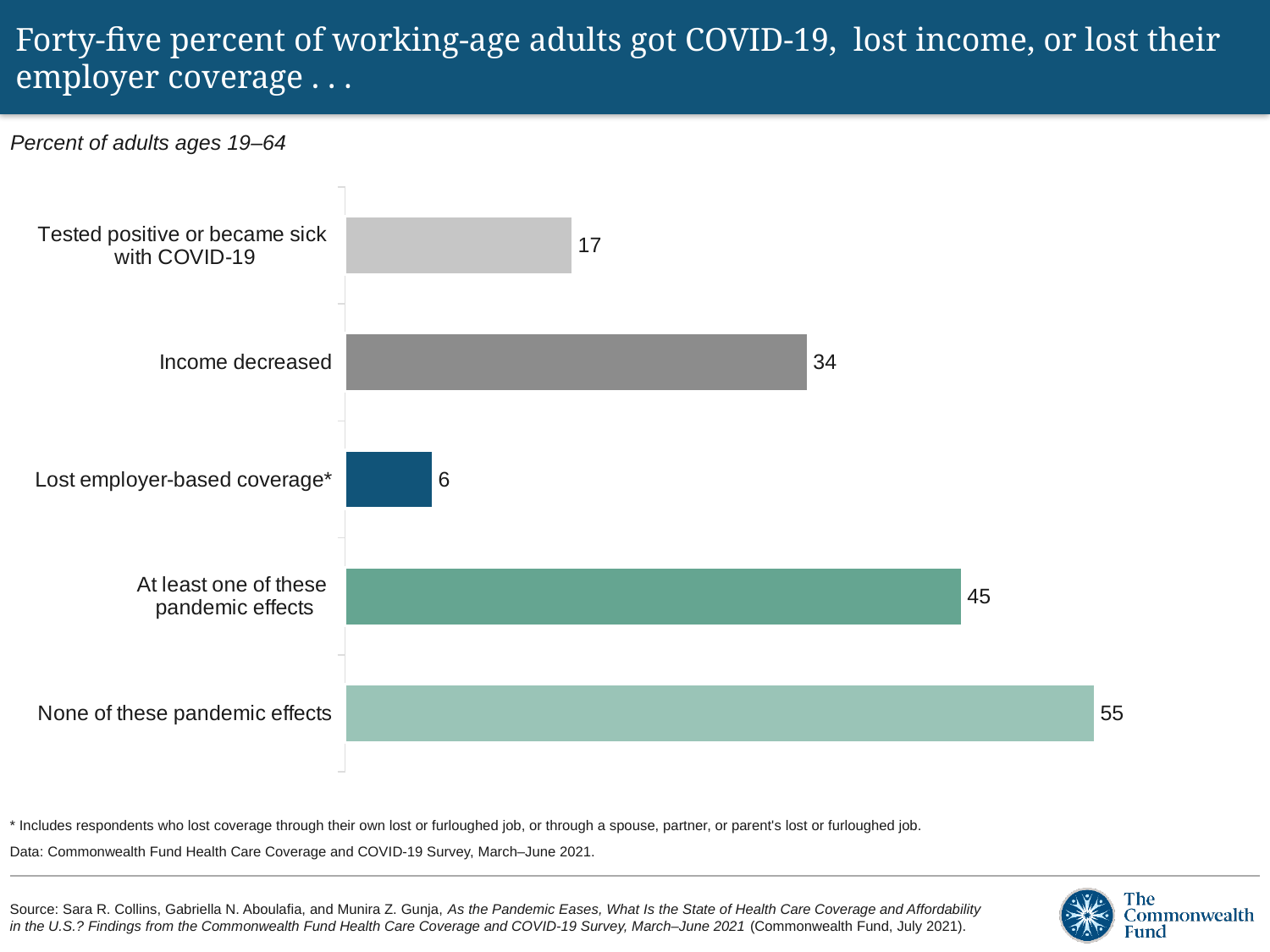
What is the value for "Tested positive or became sick with COVID-19"? 17 What is the difference between "Income decreased" and "Tested positive or became sick with COVID-19"? 17 What is the value for "At least one of these pandemic effects"? 45 Which category has the highest value? None of these pandemic effects What kind of chart is shown on the slide? Bar chart What is the value for "Income decreased"? 34 Which is larger, the value for "Income decreased" or the value for "Lost employer-based coverage*"? Income decreased What is the value for "Lost employer-based coverage*"? 6 What is the subtitle above the chart describing the measure? Percent of adults ages 19–64 What is the difference between "None of these pandemic effects" and "At least one of these pandemic effects"? 10 How many categories are shown in the chart? 5 Which category has the lowest value? Lost employer-based coverage*